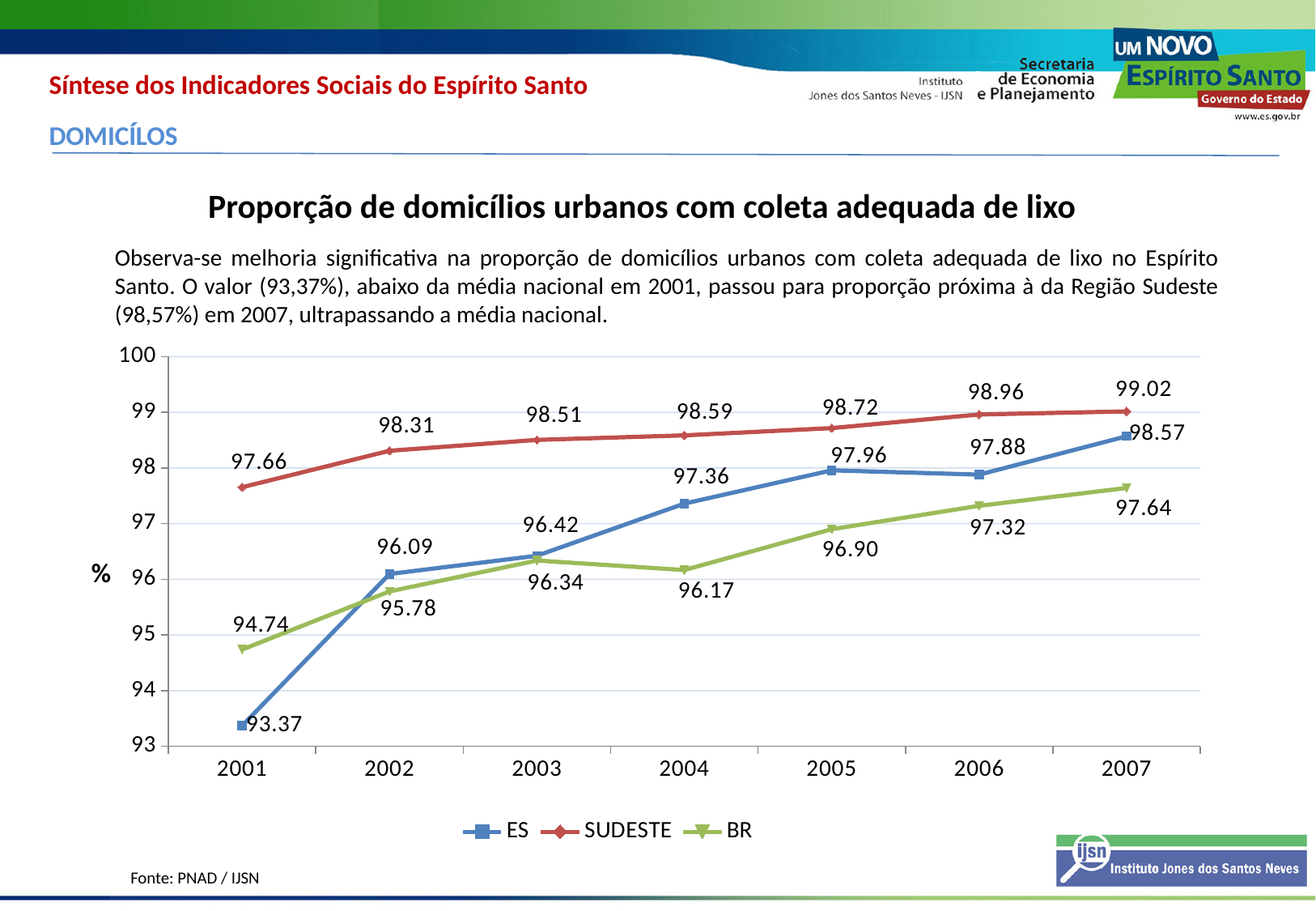
In which year is the ES series at its lowest? 2001 What is the difference between the SUDESTE and ES values in 2007? 0.45 In which year is the BR series at its highest? 2007 How many years are plotted along the x axis? 7 Which is larger in 2002, the ES value or the BR value? ES Does the SUDESTE series rise or fall from 2001 to 2007? rise How many series does the legend list? 3 What is the value for SUDESTE in 2007? 99.02 What type of chart is shown on the slide? line chart What is the value for ES in 2001? 93.37 What is the title of the chart? Proporção de domicílios urbanos com coleta adequada de lixo What is the value for BR in 2004? 96.17